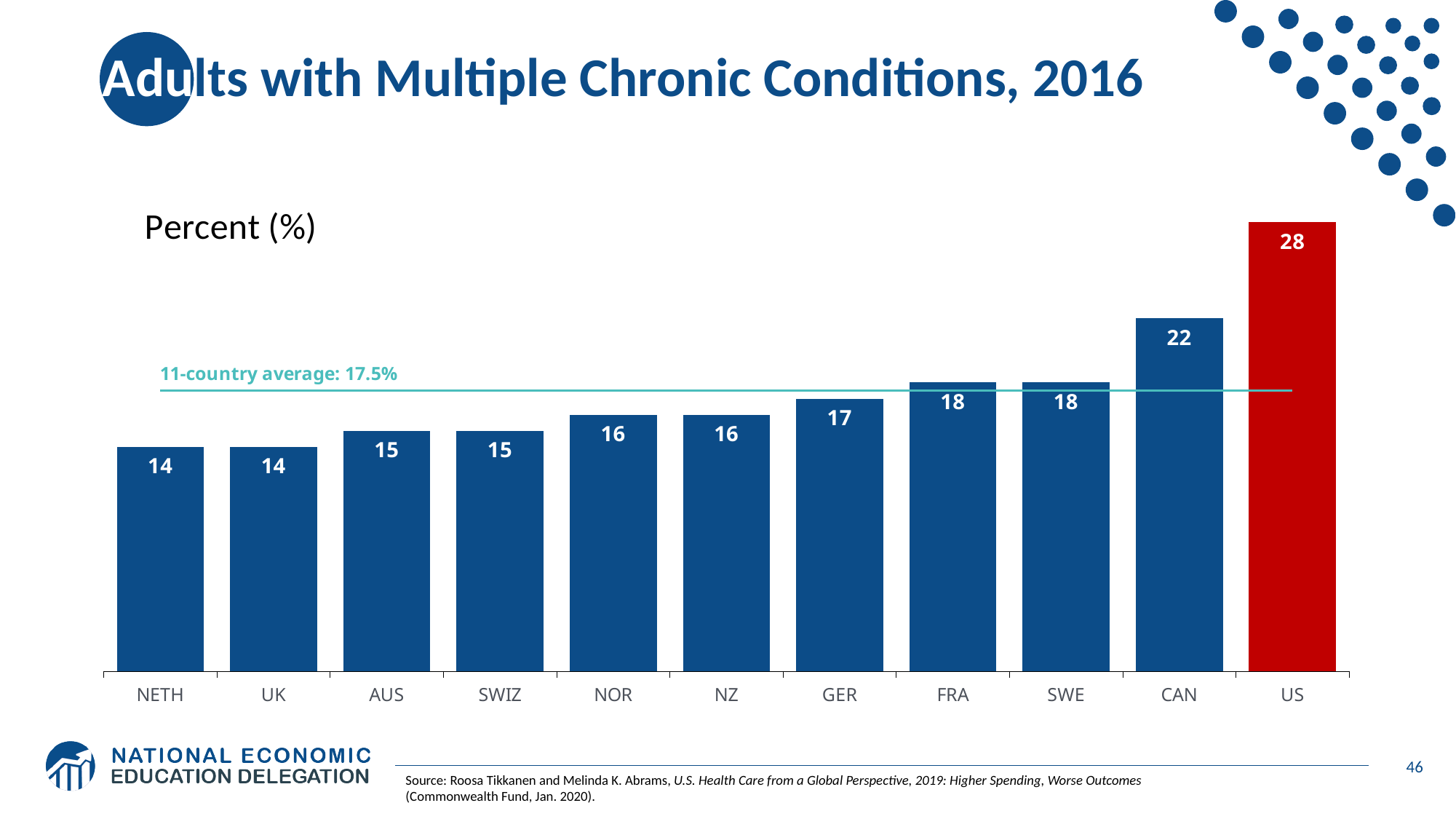
Do the values rise or fall moving from left to right along the x axis? rise What is the value for the US? 28 What is the difference between the values for the US and CAN? 6 Which is larger, the value for NOR or the value for SWE? SWE Which bar is coloured red rather than blue? US What is the value for CAN? 22 What kind of chart is shown on the slide? bar chart What is the 11-country average shown on the chart? 17.5% What is the difference between the values for FRA and NETH? 4 What is the value for GER? 17 Which country has the highest value? US How many countries are shown on the chart? 11